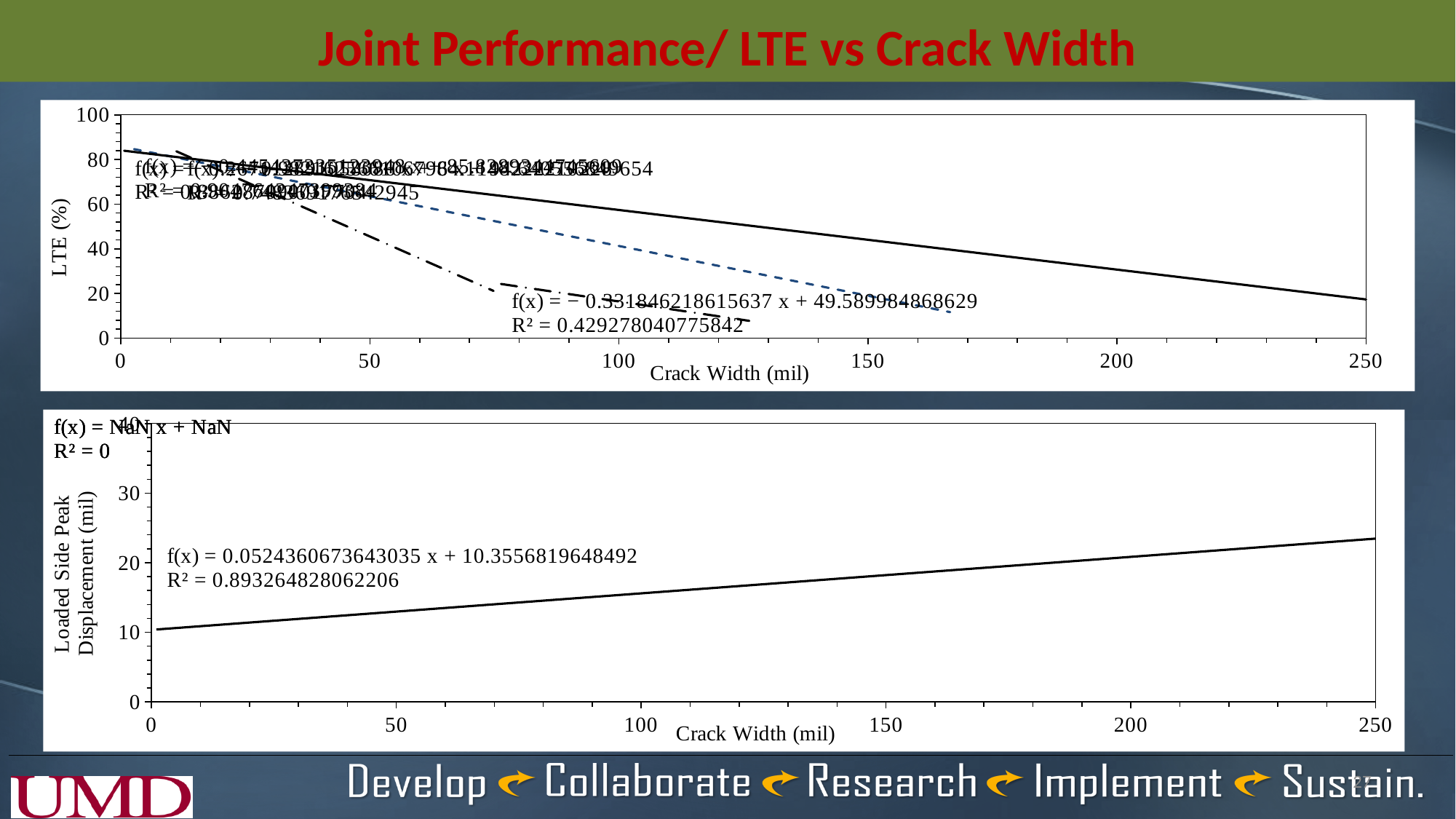
What kind of chart is the bottom chart (Loaded Side Peak Displacement vs Crack Width)? line chart In the bottom chart, does the trend line rise or fall as crack width increases? rise In the bottom chart, what is the label of the x axis? Crack Width (mil) What is the title of the slide containing the charts? Joint Performance/ LTE vs Crack Width In the top chart, what is the label of the y axis? LTE (%) In the bottom chart, is the trend line value at a crack width of 0 mil greater or less than 20? less In the top chart, is the solid trend line value at a crack width of 0 mil greater or less than 60? greater In the bottom chart, is the trend line value at a crack width of 250 mil greater or less than 20? greater In the top chart, do the trend lines rise or fall as crack width increases? fall In the top chart, what is the R² value printed for the trend line f(x) = -0.331846218615637 x + 49.589984868629? 0.429278040775842 In the bottom chart, what is the R² value printed for the trend line f(x) = 0.0524360673643035 x + 10.3556819648492? 0.893264828062206